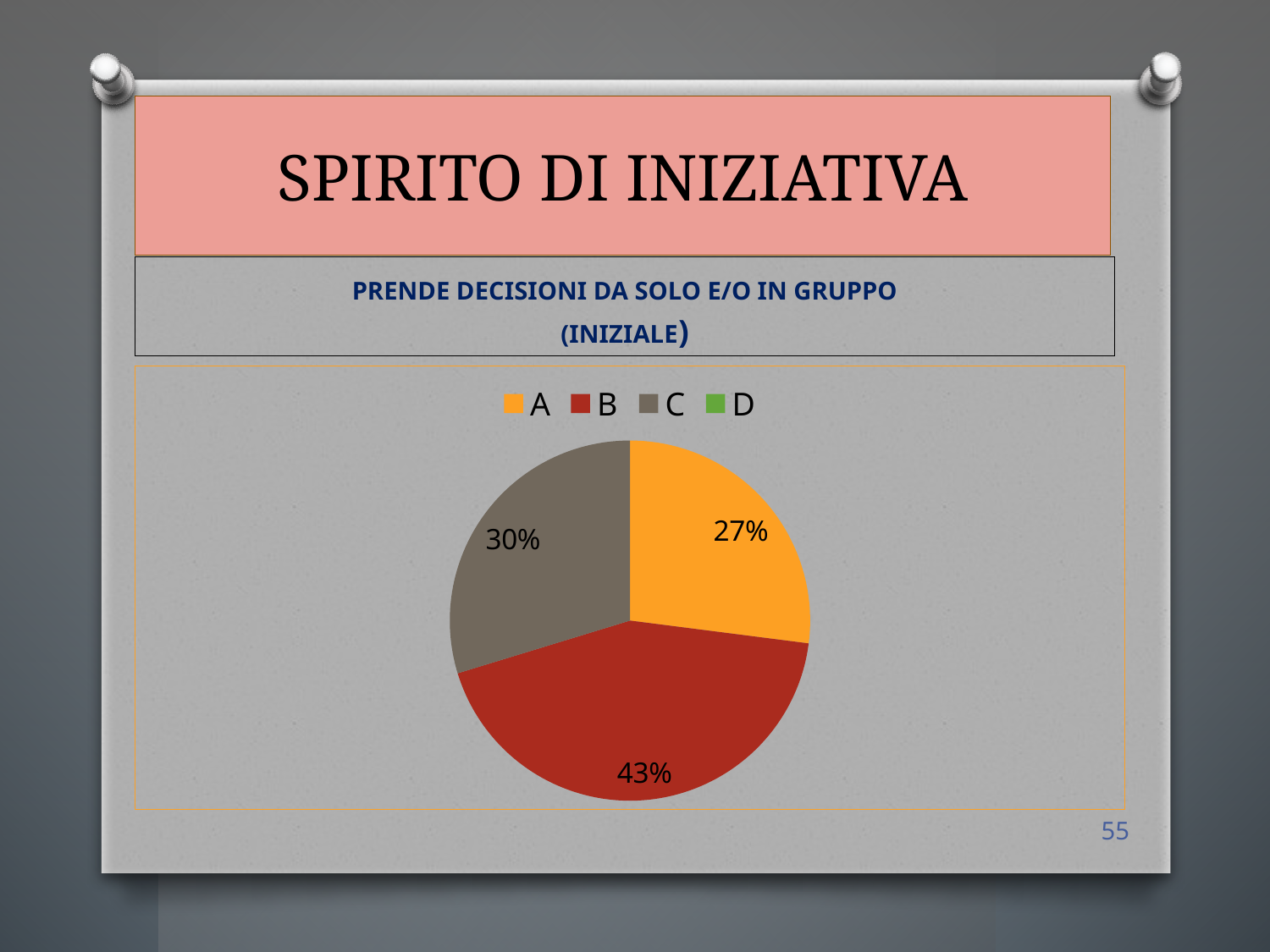
What kind of chart is shown on the slide? Pie chart What is the difference in percentage points between slice B and slice A? 16% What is the title of the chart? PRENDE DECISIONI DA SOLO E/O IN GRUPPO (INIZIALE) Which is larger, the slice for A or the slice for C? C Which category has the largest slice of the pie? B What is the difference in percentage points between slice B and slice C? 13% What percentage of the pie does slice C represent? 30% How many slices with data labels are visible in the pie? 3 What percentage of the pie does slice B represent? 43% What colour is the slice for category B? Red What percentage of the pie does slice A represent? 27% How many entries does the legend list? 4